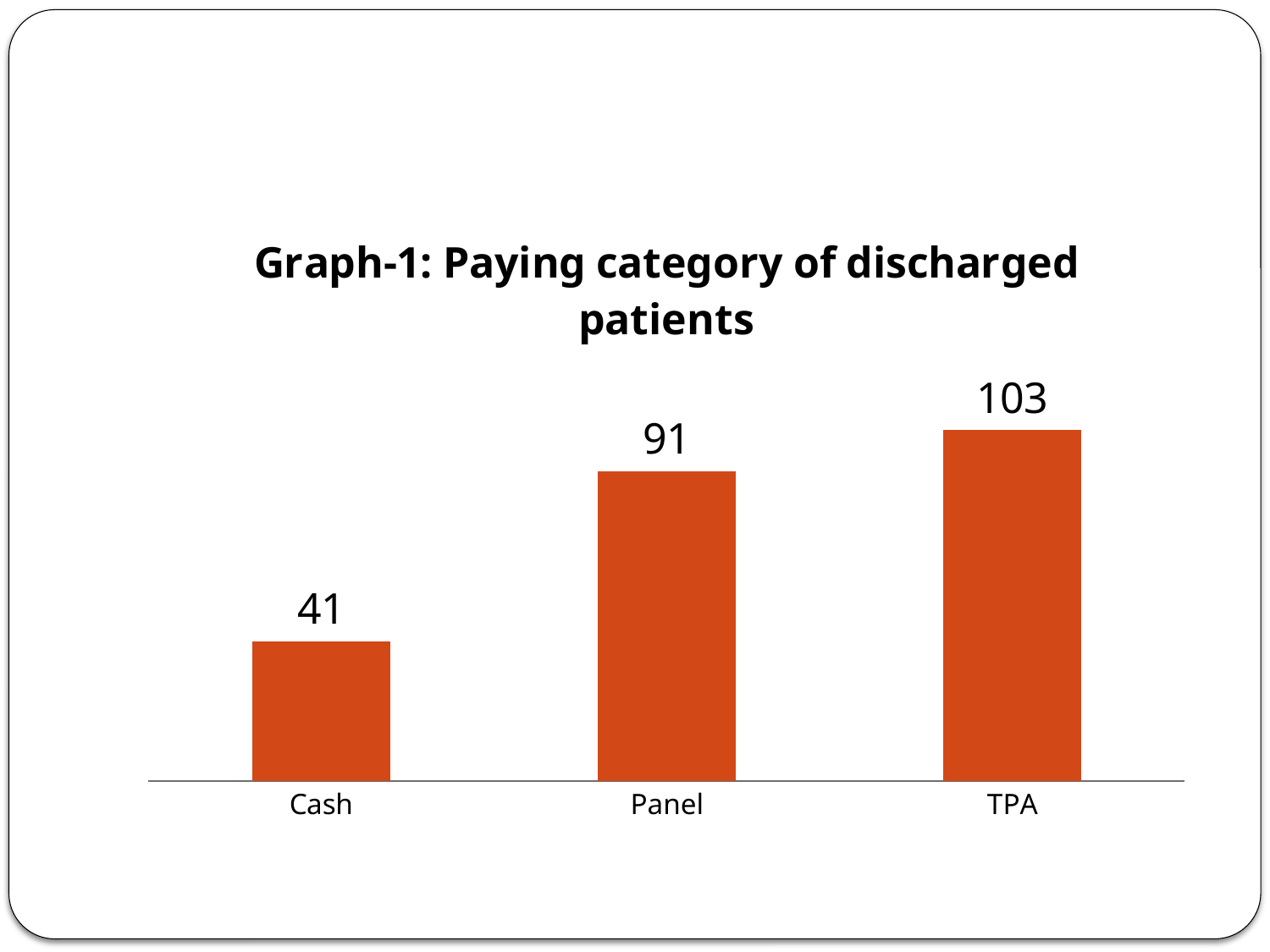
How many paying categories are shown in the chart? 3 Which paying category has the lowest value? Cash What is the difference between the values for TPA and Panel? 12 What is the title of the chart? Graph-1: Paying category of discharged patients Which is larger, the value for Panel or the value for Cash? Panel What is the value for Cash? 41 What is the value for TPA? 103 What kind of chart is shown on the slide? Bar chart Which paying category has the highest value? TPA What is the difference between the values for TPA and Cash? 62 What is the value for Panel? 91 What is the difference between the values for Panel and Cash? 50